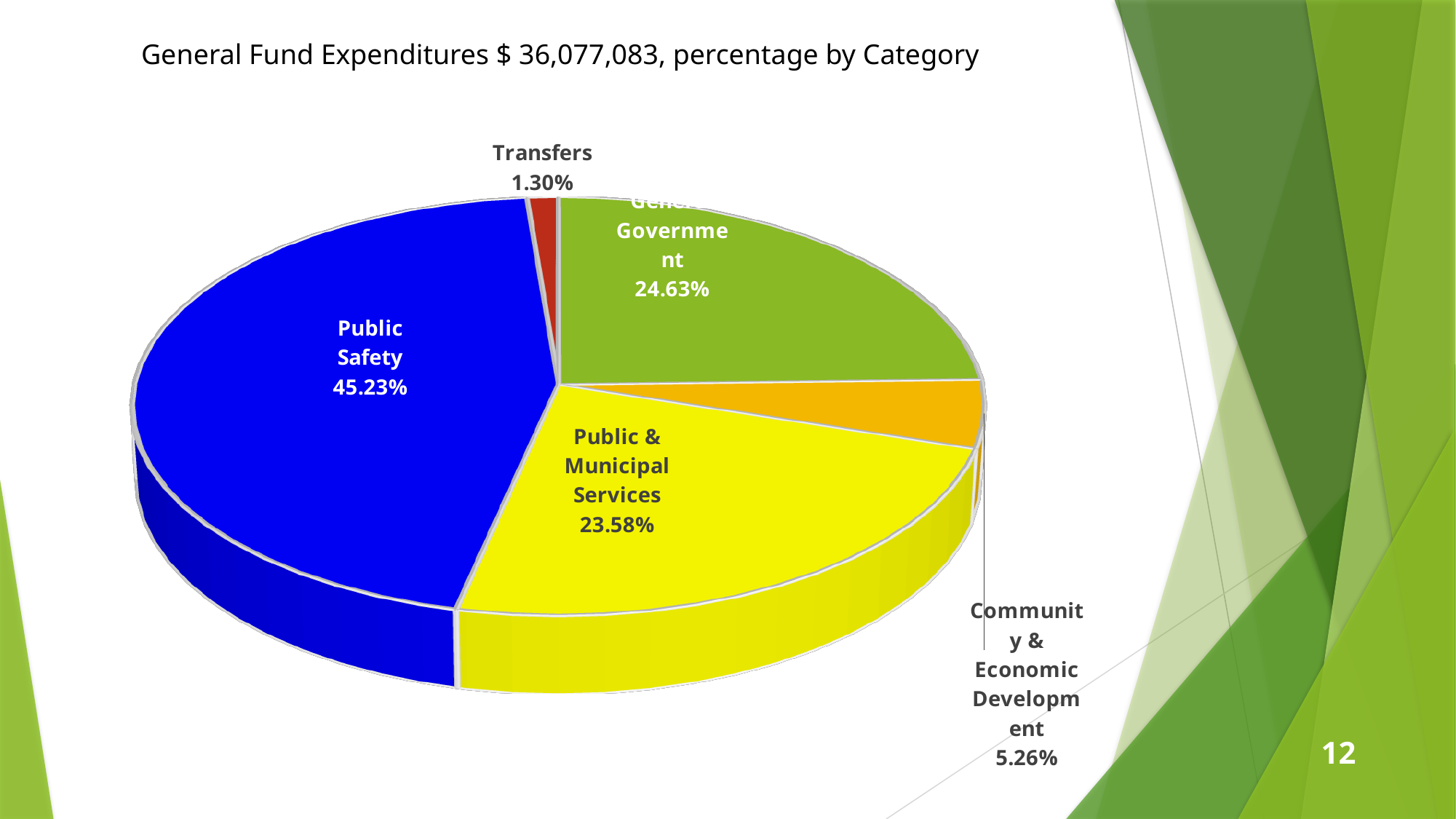
What is the difference in percentage points between Public Safety and General Government? 20.60 Which category has the smallest share of General Fund Expenditures? Transfers What total dollar amount of General Fund Expenditures is stated in the chart title? $ 36,077,083 What percentage of General Fund Expenditures goes to Community & Economic Development? 5.26% Which category has the largest share of General Fund Expenditures? Public Safety What percentage of General Fund Expenditures goes to Transfers? 1.30% How many categories are shown in the pie chart? 5 What percentage of General Fund Expenditures goes to Public Safety? 45.23% What is the difference in percentage points between Community & Economic Development and Transfers? 3.96 Which has a larger share, General Government or Public & Municipal Services? General Government What kind of chart is shown on the slide? Pie chart What percentage of General Fund Expenditures goes to Public & Municipal Services? 23.58%